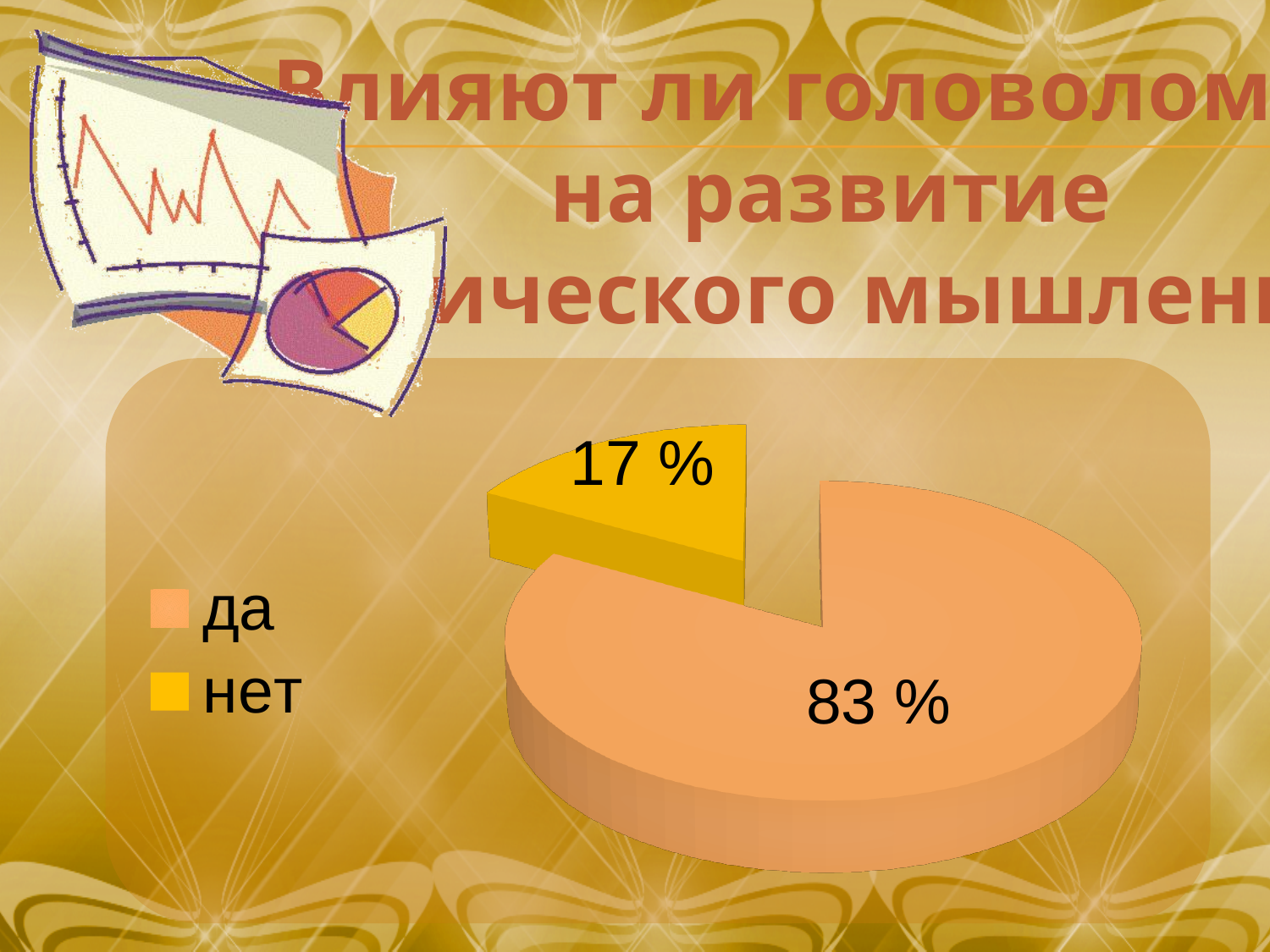
What colour is the "нет" slice in the pie chart? yellow How many slices does the pie chart have? 2 What kind of chart is shown on the slide? pie chart What is the value for "нет" in the pie chart? 17 % What is the value for "да" in the pie chart? 83 % Which is larger, the value for "да" or the value for "нет"? да Which category has the smallest slice of the pie? нет What colour is the "да" slice in the pie chart? orange What is the difference between the "да" and "нет" values? 66 % How many entries does the legend list? 2 Which category has the largest slice of the pie? да What share of the pie does the "нет" slice represent? 17 %